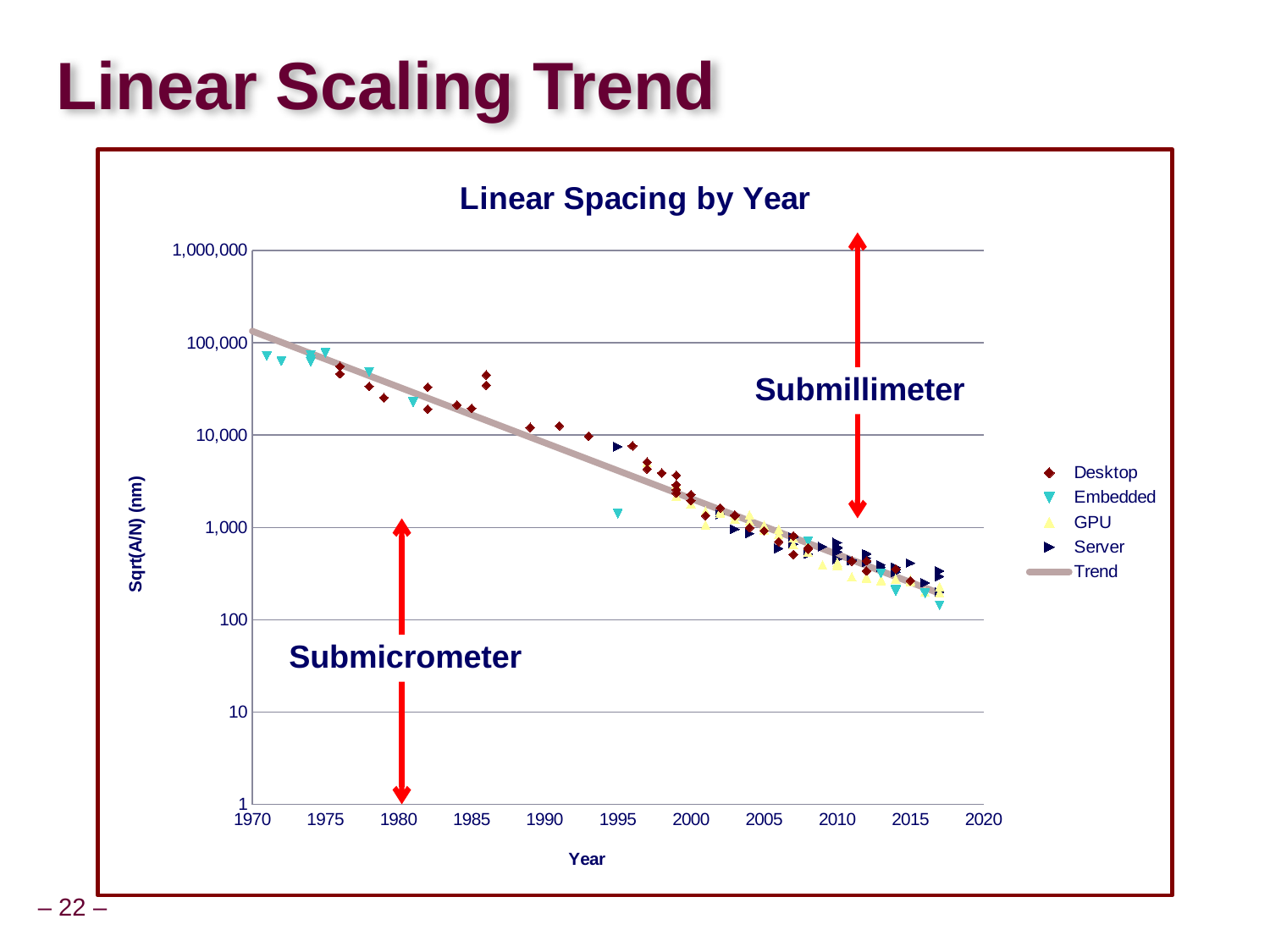
How many year tick labels are shown on the x axis? 11 Are the Desktop values around 1985 greater or less than 10,000? greater What is the label of the y axis? Sqrt(A/N) (nm) Is the Embedded point near 1995 greater or less than 10,000? less Are the Desktop values around 2015 greater or less than 1,000? less Which series is drawn as a line rather than as markers? Trend Do the plotted values rise or fall as the year increases along the x axis? fall What kind of chart is shown on the slide? scatter chart What is the title of the chart? Linear Spacing by Year How many series does the legend list? 5